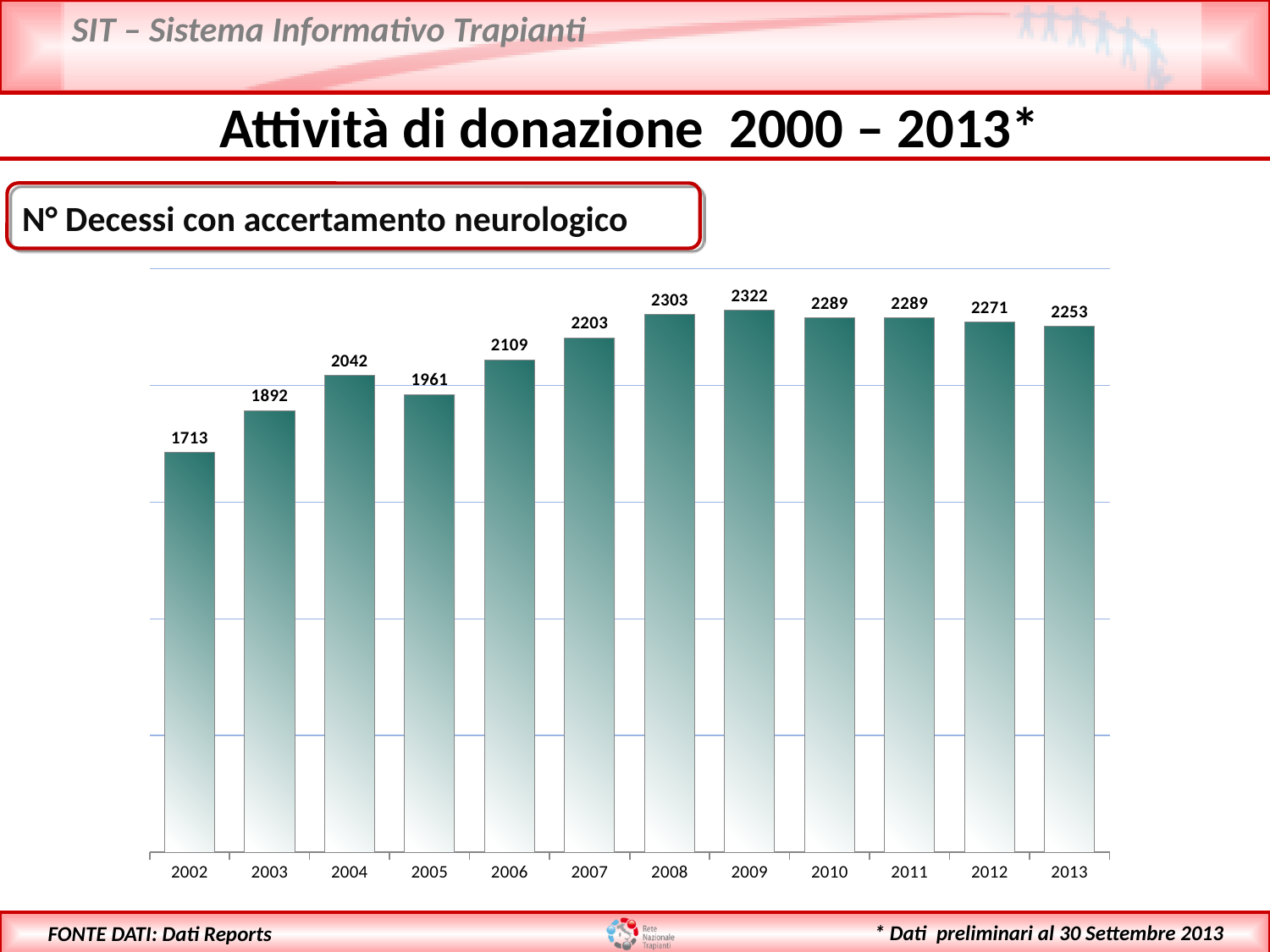
What is the difference between the values for 2004 and 2005? 81 What is the value for 2005? 1961 How many years are shown on the x axis? 12 Which year has the lowest value? 2002 What is the value for 2009? 2322 What is the value for 2013? 2253 What kind of chart is shown? Bar chart Do the values rise or fall from 2009 to 2013? Fall Which is larger, the value for 2004 or the value for 2005? 2004 What is the value for 2002? 1713 Which year has the highest value? 2009 What is the difference between the values for 2009 and 2002? 609